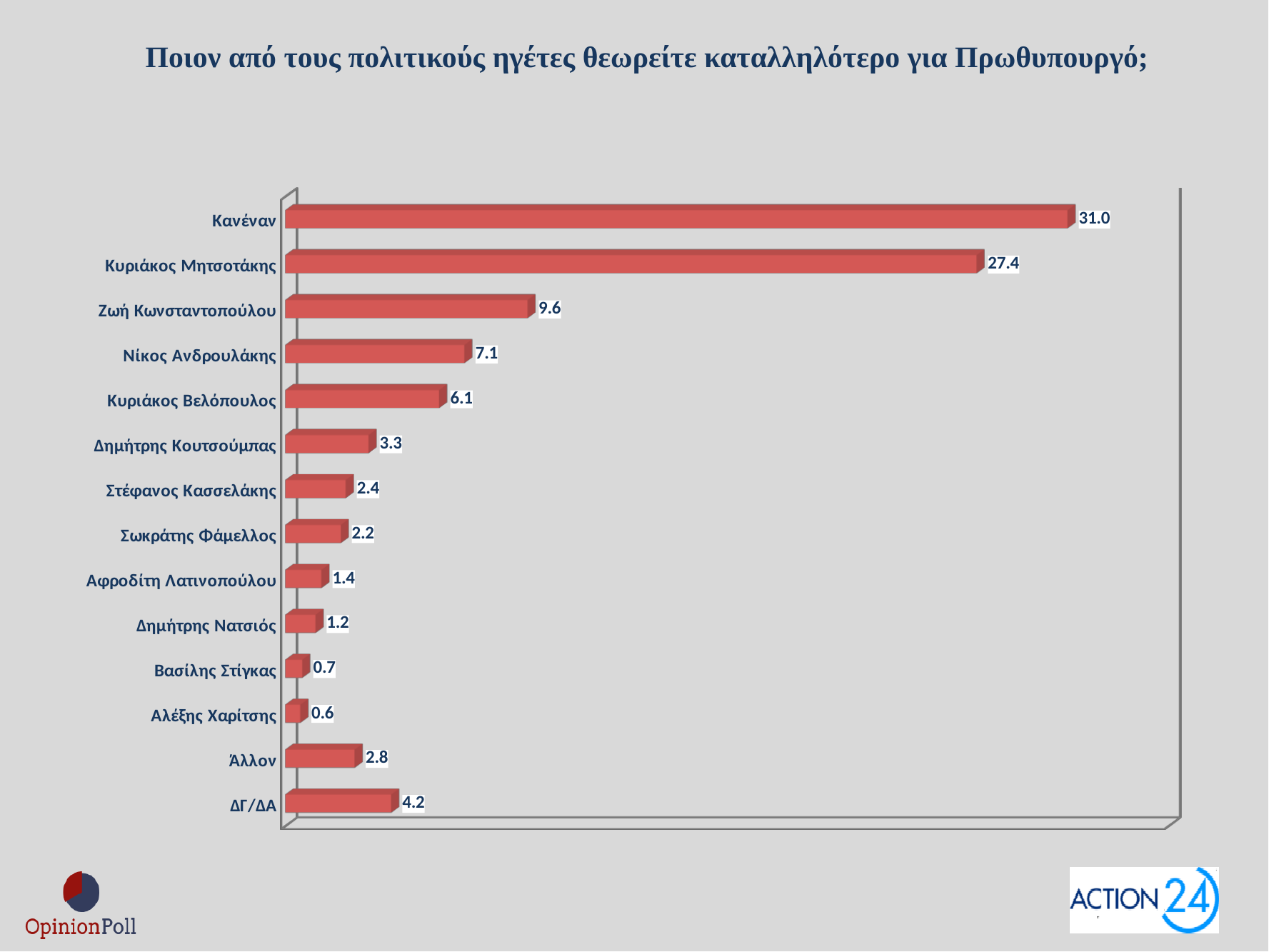
What value is shown for Ζωή Κωνσταντοπούλου? 9.6 What is the difference between the values for Νίκος Ανδρουλάκης and Κυριάκος Βελόπουλος? 1.0 What value is shown for Κυριάκος Μητσοτάκης? 27.4 What kind of chart is shown on the slide? Bar chart Which has a larger value, Στέφανος Κασσελάκης or Δημήτρης Κουτσούμπας? Δημήτρης Κουτσούμπας Which category has the lowest value? Αλέξης Χαρίτσης What is the title of the chart? Ποιον από τους πολιτικούς ηγέτες θεωρείτε καταλληλότερο για Πρωθυπουργό; How many categories are shown in the chart? 14 What value is shown for Κυριάκος Βελόπουλος? 6.1 What is the difference between the values for Κανέναν and Κυριάκος Μητσοτάκης? 3.6 Which category has the highest value? Κανέναν What value is shown for ΔΓ/ΔΑ? 4.2